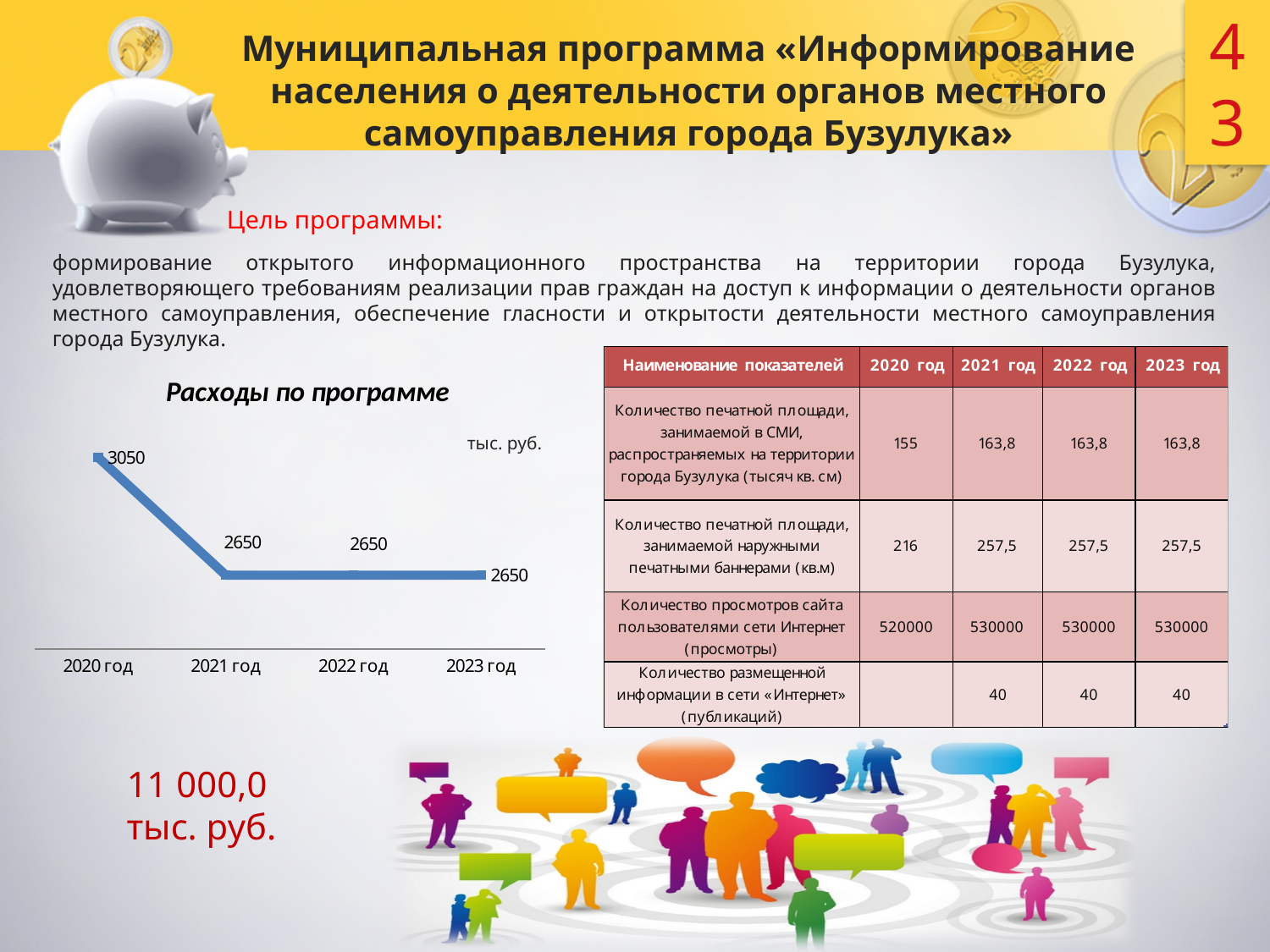
What is the title of the line chart on the slide? Расходы по программе In the chart "Расходы по программе", which is larger: the value for 2020 год or the value for 2022 год? 2020 год In the chart "Расходы по программе", what is the value for 2021 год? 2650 What type of chart is "Расходы по программе"? line chart In the chart "Расходы по программе", do the values rise or fall from 2020 год to 2021 год? fall In the chart "Расходы по программе", what is the difference between the values for 2020 год and 2021 год? 400 In the chart "Расходы по программе", do the values change between 2021 год and 2023 год? No, they stay at 2650 In the chart "Расходы по программе", what is the value for 2023 год? 2650 In the chart "Расходы по программе", which year has the highest value? 2020 год In the chart "Расходы по программе", what is the value for 2020 год? 3050 What unit is indicated on the chart "Расходы по программе"? тыс. руб. How many years (categories) are shown on the x axis of the chart "Расходы по программе"? 4